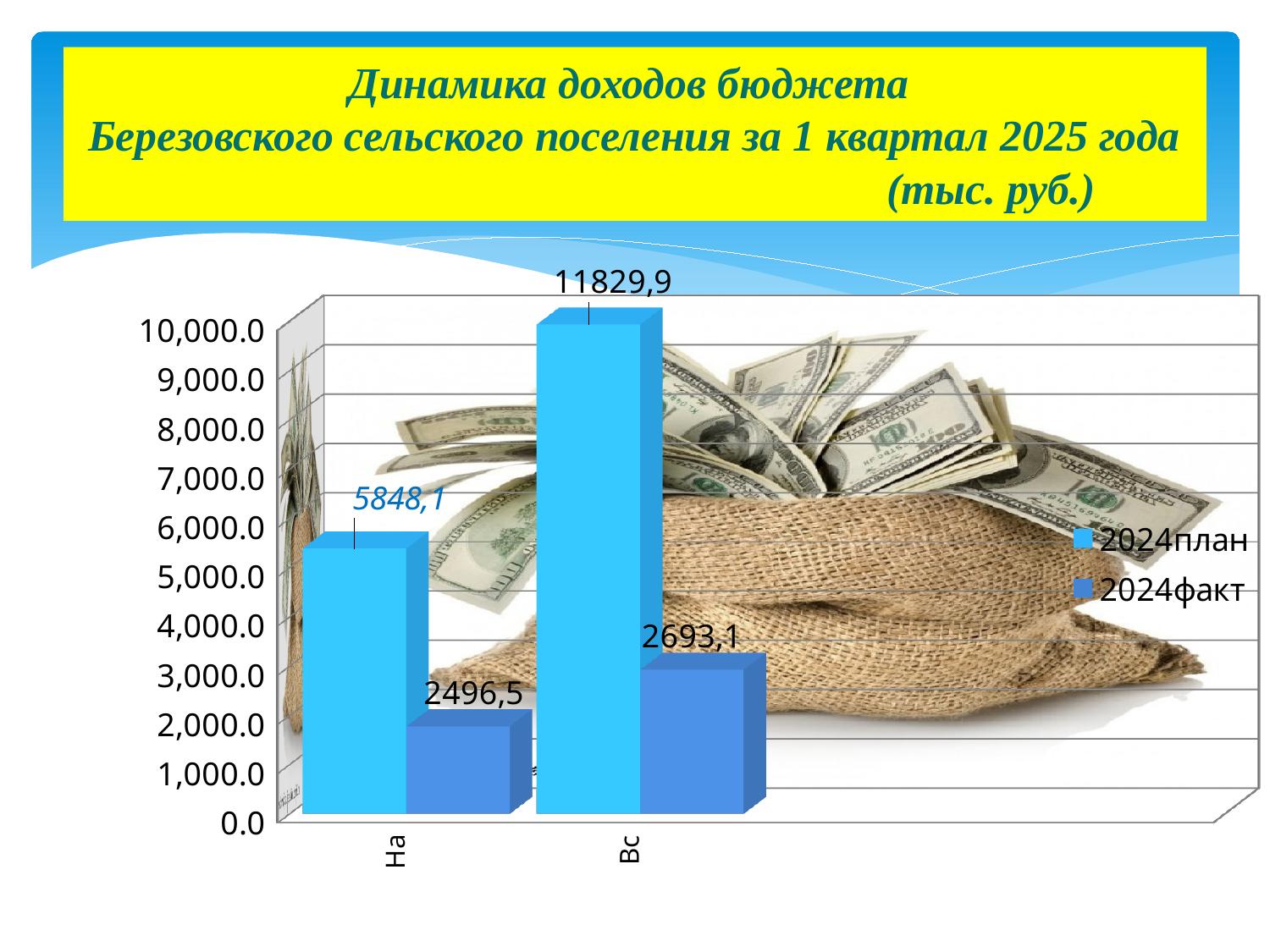
What is the value of the 2024план bar for the category labelled "На"? 5848,1 Which is larger: the 2024план value for "На" or the 2024план value for "Вс"? 2024план for Вс What are the two series named in the legend? 2024план and 2024факт What is the value of the 2024факт bar for the category labelled "На"? 2496,5 How many series does the legend list? 2 What is the difference between the 2024план and 2024факт values for the category labelled "Вс"? 9136,8 What is the difference between the 2024план and 2024факт values for the category labelled "На"? 3351,6 What is the value of the 2024план bar for the category labelled "Вс"? 11829,9 Which bar on the chart has the lowest value? 2024факт for На (2496,5) What kind of chart is shown on the slide? Bar chart What is the value of the 2024факт bar for the category labelled "Вс"? 2693,1 Which bar on the chart has the highest value? 2024план for Вс (11829,9)